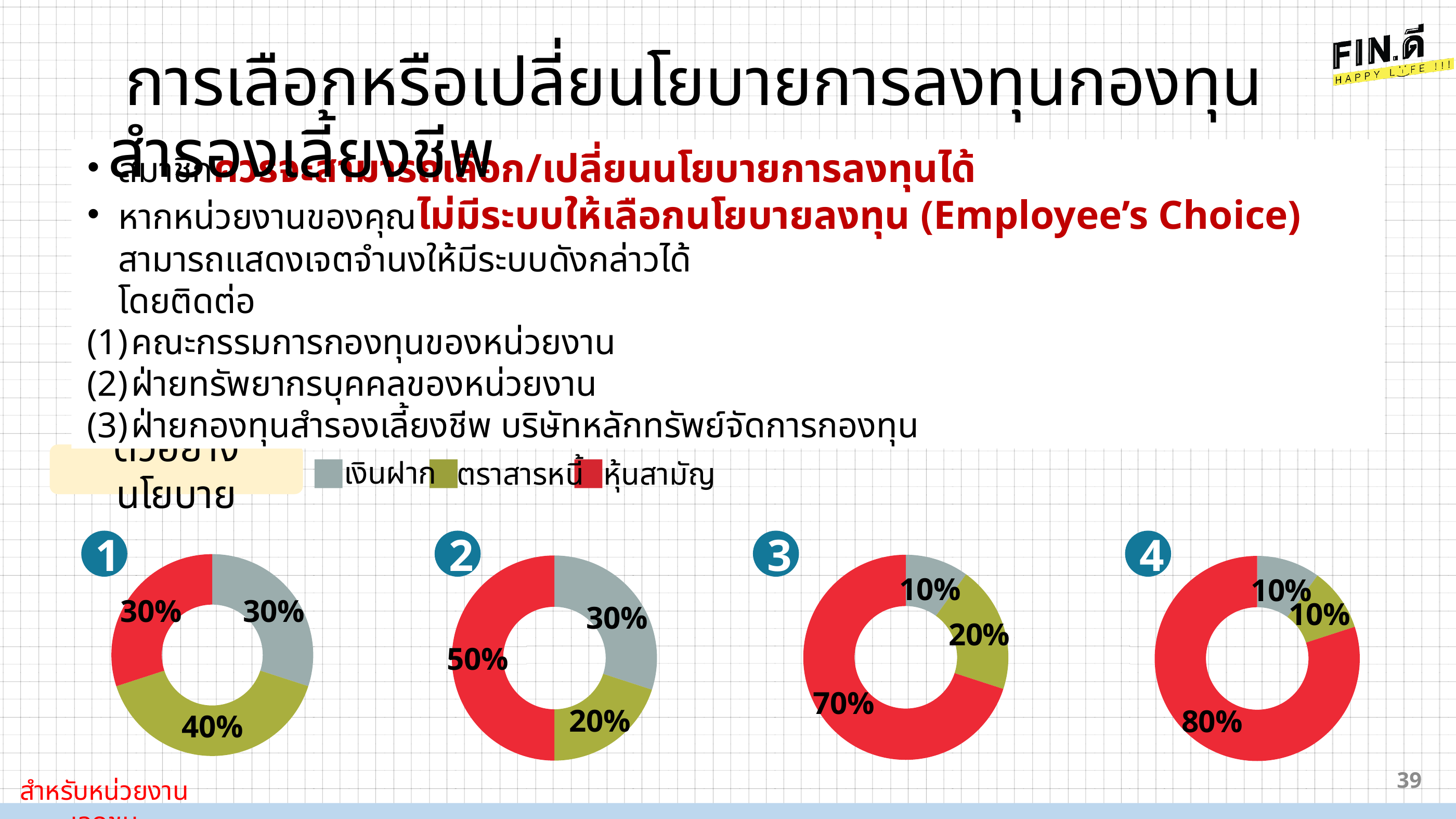
In donut chart 4, what is the difference between the หุ้นสามัญ share and the ตราสารหนี้ share? 70% How many categories does the shared legend for the donut charts list? 3 In donut chart 1, which category has the largest share? ตราสารหนี้ In donut chart 1, what share is ตราสารหนี้? 40% In donut chart 4, what share is หุ้นสามัญ? 80% In donut chart 2, what is the difference between the หุ้นสามัญ share and the เงินฝาก share? 20% In donut chart 3, what share is หุ้นสามัญ? 70% In donut chart 2, which category has the smallest share? ตราสารหนี้ In donut chart 3, which is larger, เงินฝาก or ตราสารหนี้? ตราสารหนี้ What type of chart is used for the four numbered policy examples? Donut (pie) chart